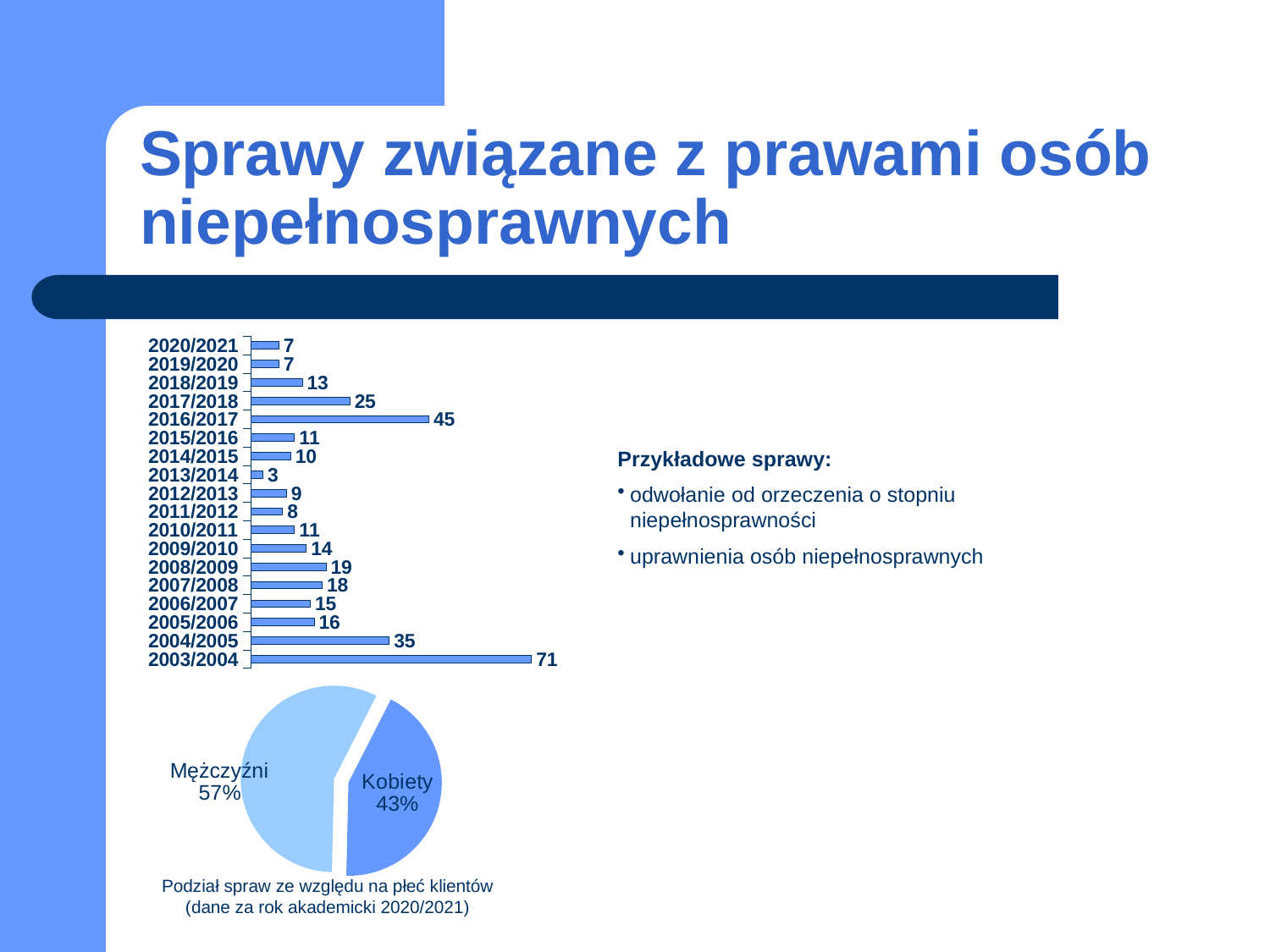
What kind of chart is the chart at the top left of the slide? Bar chart In the bar chart at the top left, what is the value for 2008/2009? 19 In the pie chart at the bottom left, what share is labelled Kobiety? 43% In the bar chart at the top left, what is the value for 2013/2014? 3 In the bar chart at the top left, what is the value for 2016/2017? 45 In the bar chart at the top left, what is the difference between the values for 2003/2004 and 2004/2005? 36 What kind of chart is the chart at the bottom left of the slide? Pie chart In the bar chart at the top left, which is larger, the value for 2017/2018 or the value for 2018/2019? 2017/2018 In the pie chart at the bottom left, what share is labelled Mężczyźni? 57% In the bar chart at the top left, which academic year has the lowest value? 2013/2014 How many academic years are shown in the bar chart at the top left? 18 In the bar chart at the top left, which academic year has the highest value? 2003/2004